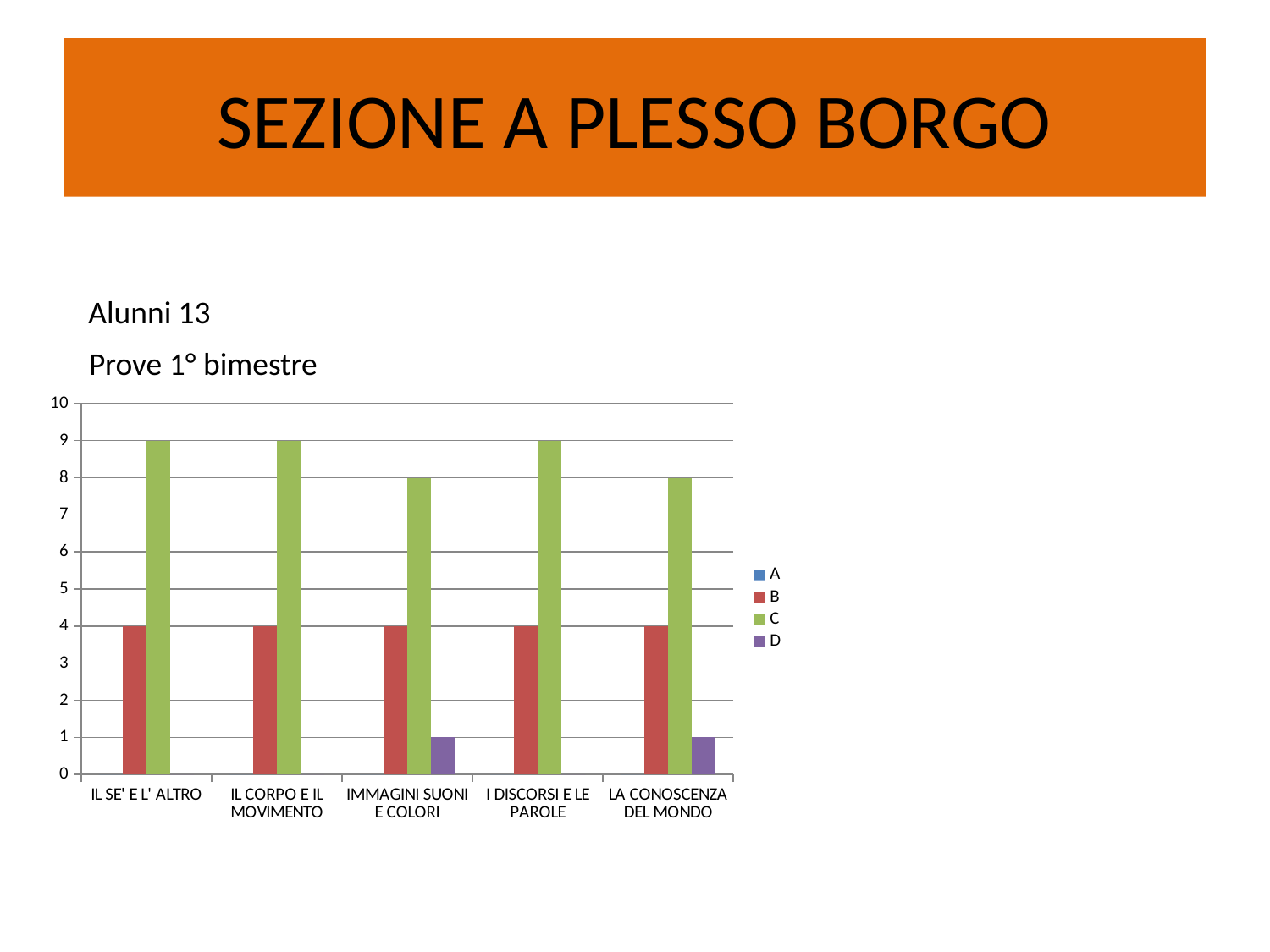
What is the value of series C for IMMAGINI SUONI E COLORI? 8 What is the value of series C for IL SE' E L' ALTRO? 9 Is the value of series C for LA CONOSCENZA DEL MONDO greater or less than 5? greater Which is larger for IMMAGINI SUONI E COLORI, series B or series D? B What is the value of series B for I DISCORSI E LE PAROLE? 4 Which series has the highest value for IL CORPO E IL MOVIMENTO? C What kind of chart is shown on the slide? bar chart What is the value of series D for LA CONOSCENZA DEL MONDO? 1 How many series does the legend list? 4 What is the difference between series C and series B for IL SE' E L' ALTRO? 5 What colour are the bars for series C? green How many categories are shown on the x axis? 5